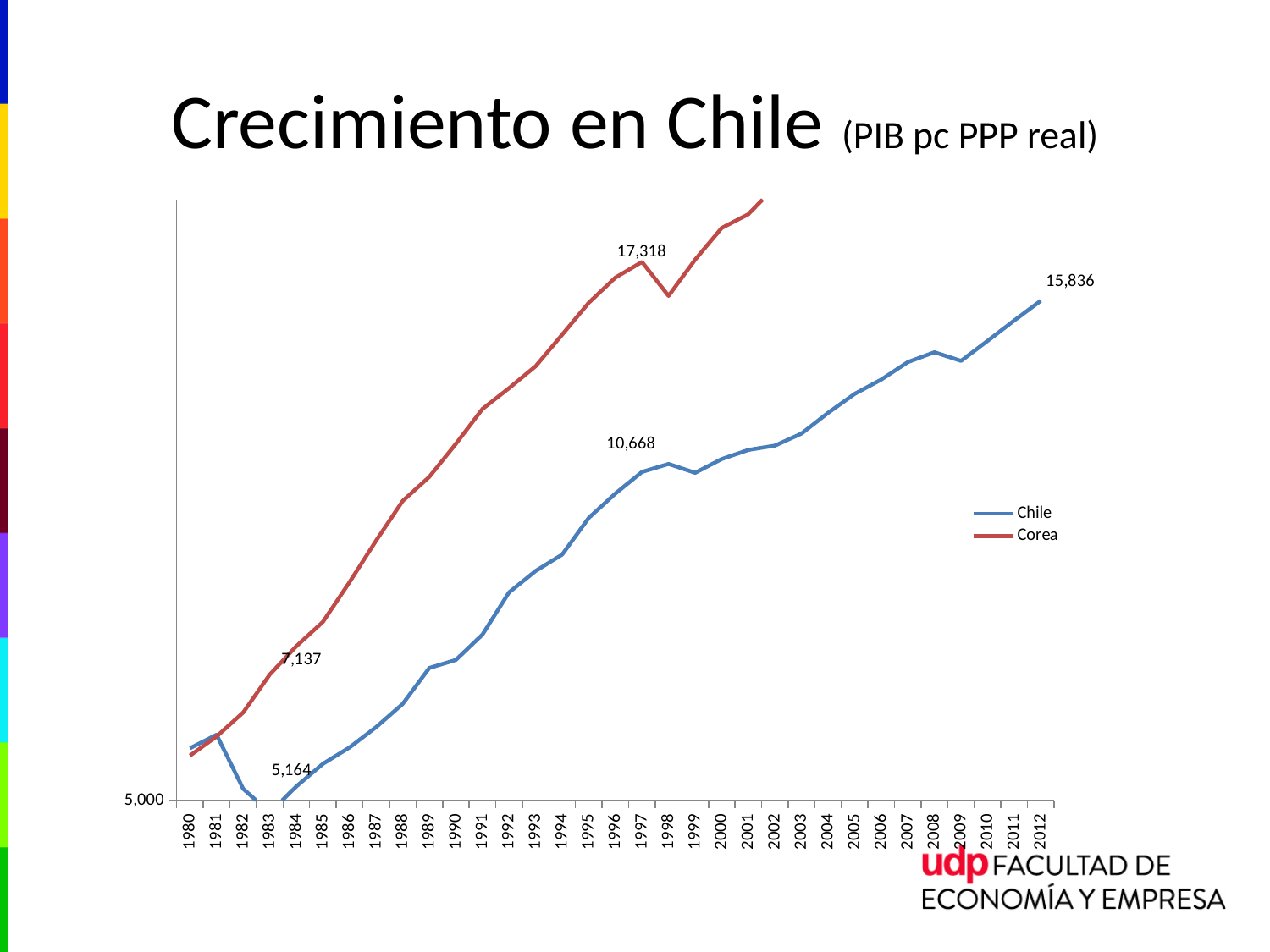
What is the labelled value for Chile in 1997? 10,668 By how much does the labelled Chile value in 2012 exceed the labelled Chile value in 1997? 5,168 How many series does the legend list? 2 What kind of chart is shown on the slide? line chart Does the Chile line overall rise or fall from 1980 to 2012? rise What is the title of the slide? Crecimiento en Chile (PIB pc PPP real) What is the labelled value for Chile in 2012? 15,836 What is the labelled value for Corea in 1997? 17,318 What is the difference between the labelled Corea value and the labelled Chile value in 1997? 6,650 In 1997, which series has the higher value, Chile or Corea? Corea What are the two series named in the legend? Chile and Corea What is the lowest labelled value on the Chile line? 5,164